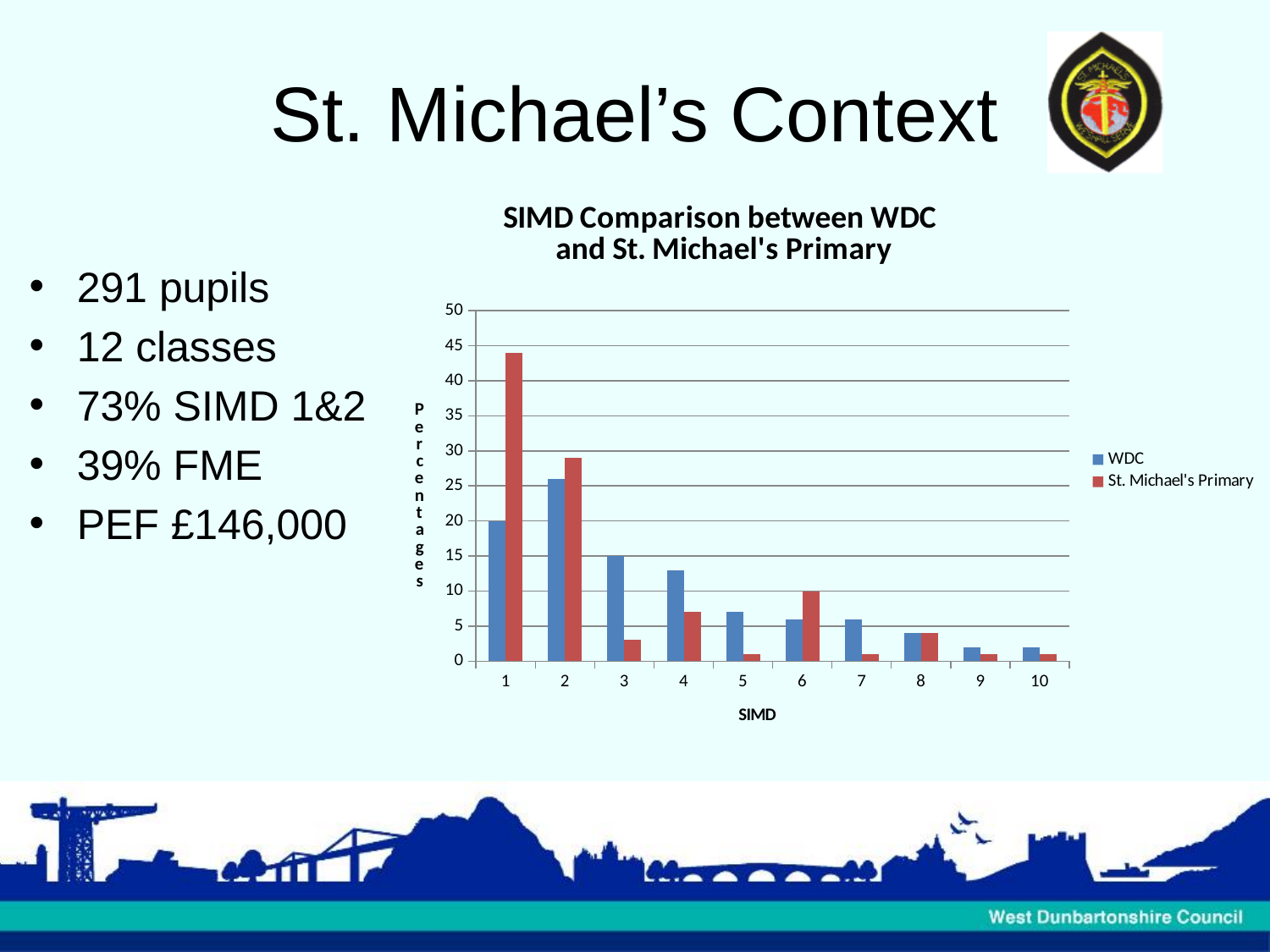
How many SIMD categories are shown on the x axis of the chart? 10 For which SIMD category is the St. Michael's Primary bar highest? 1 For which SIMD category is the WDC bar highest? 2 What is the title of the chart? SIMD Comparison between WDC and St. Michael's Primary Is the St. Michael's Primary value for SIMD 1 greater or less than 40? greater Is the WDC value for SIMD 4 greater or less than 10? greater How many series does the chart legend list? 2 What is the label on the x axis of the chart? SIMD For SIMD 3, which series has the larger value, WDC or St. Michael's Primary? WDC What kind of chart is shown on the slide? bar chart Do the WDC values generally rise or fall as SIMD goes from 1 to 10? fall Is the St. Michael's Primary value for SIMD 3 greater or less than 5? less